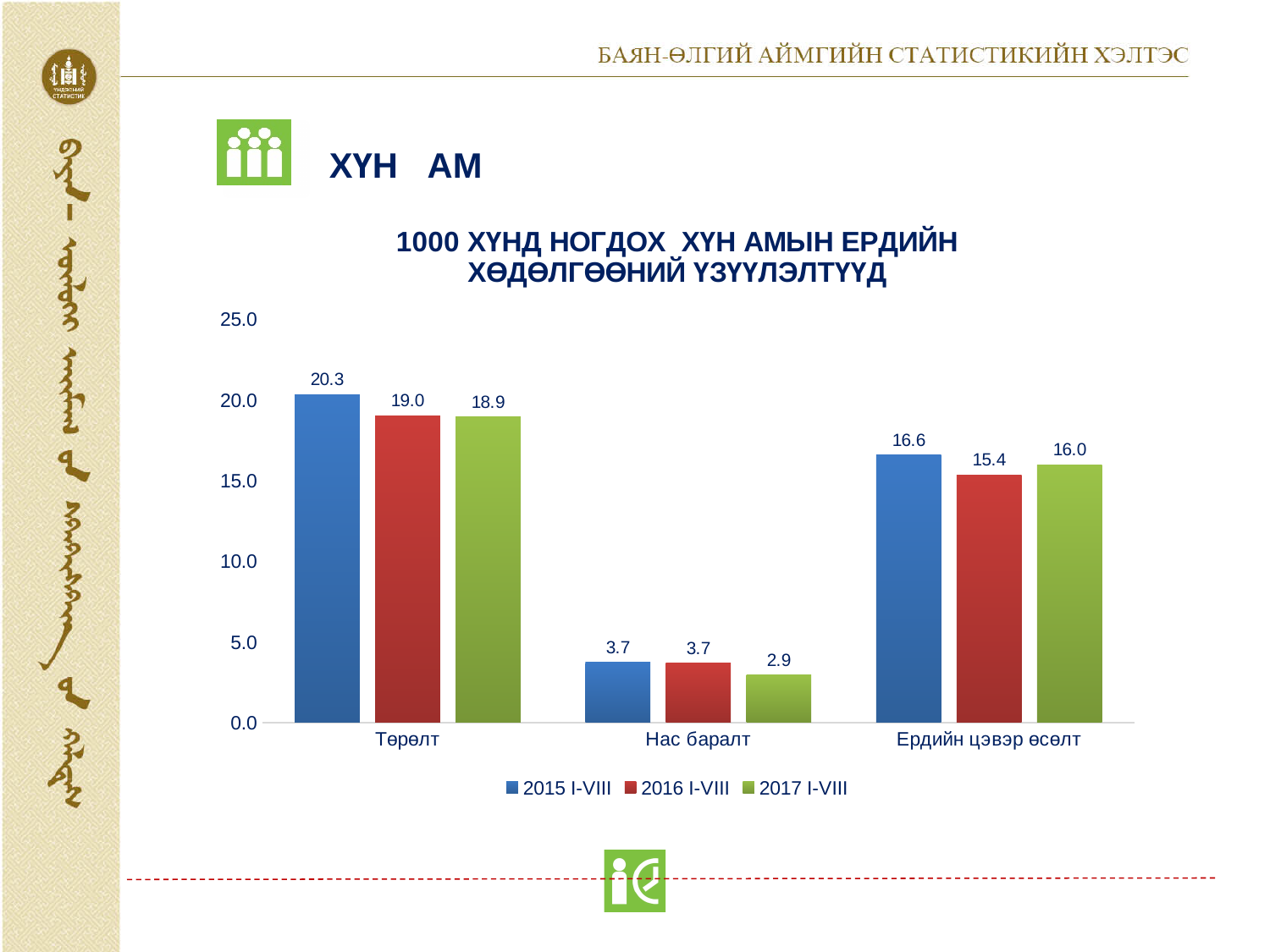
Which is larger for Ердийн цэвэр өсөлт: the 2015 I-VIII value or the 2017 I-VIII value? 2015 I-VIII Which category has the highest value in the 2017 I-VIII series? Төрөлт How many categories are shown on the x axis? 3 How many series does the legend list? 3 What is the value for Нас баралт in the 2017 I-VIII series? 2.9 What is the value for Төрөлт in the 2015 I-VIII series? 20.3 What kind of chart is shown on the slide? bar chart Which category has the lowest value in the 2015 I-VIII series? Нас баралт What is the difference between the 2015 I-VIII and 2017 I-VIII values for Төрөлт? 1.4 Which series is shown in green in the legend? 2017 I-VIII What is the value for Ердийн цэвэр өсөлт in the 2016 I-VIII series? 15.4 Is the 2016 I-VIII value for Ердийн цэвэр өсөлт greater or less than 15.0? greater